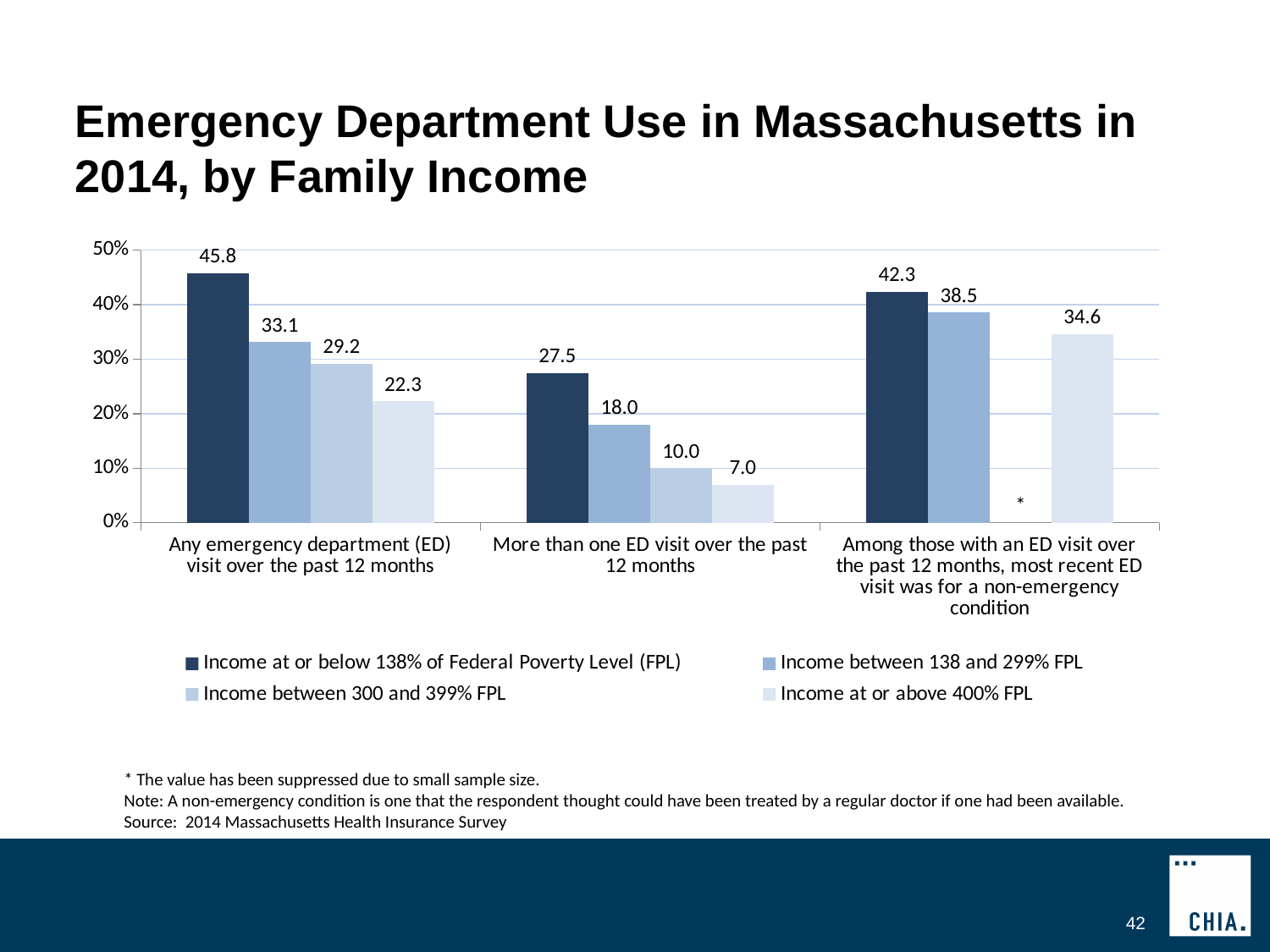
What is the value for 'Income at or above 400% FPL' in the 'More than one ED visit over the past 12 months' category? 7.0 How many categories are shown on the x axis? 3 Which income group has the highest value in the 'Any emergency department (ED) visit over the past 12 months' category? Income at or below 138% of Federal Poverty Level (FPL) Is the value for 'Income at or below 138% of Federal Poverty Level (FPL)' in the 'More than one ED visit over the past 12 months' category greater or less than 30%? less What is the value for 'Income at or below 138% of Federal Poverty Level (FPL)' in the 'Any emergency department (ED) visit over the past 12 months' category? 45.8 Which income group's value is suppressed (marked with an asterisk) in the 'Among those with an ED visit over the past 12 months, most recent ED visit was for a non-emergency condition' category? Income between 300 and 399% FPL What is the value for 'Income between 138 and 299% FPL' in the 'Among those with an ED visit over the past 12 months, most recent ED visit was for a non-emergency condition' category? 38.5 Which is larger: the 'Income between 300 and 399% FPL' value for 'Any emergency department (ED) visit over the past 12 months' or the 'Income between 138 and 299% FPL' value for 'More than one ED visit over the past 12 months'? Income between 300 and 399% FPL for Any emergency department (ED) visit over the past 12 months How many series does the legend list? 4 Which income group has the lowest value in the 'More than one ED visit over the past 12 months' category? Income at or above 400% FPL What kind of chart is shown on the slide? Bar chart What is the difference between the 'Income at or below 138% of Federal Poverty Level (FPL)' and 'Income at or above 400% FPL' values in the 'Any emergency department (ED) visit over the past 12 months' category? 23.5